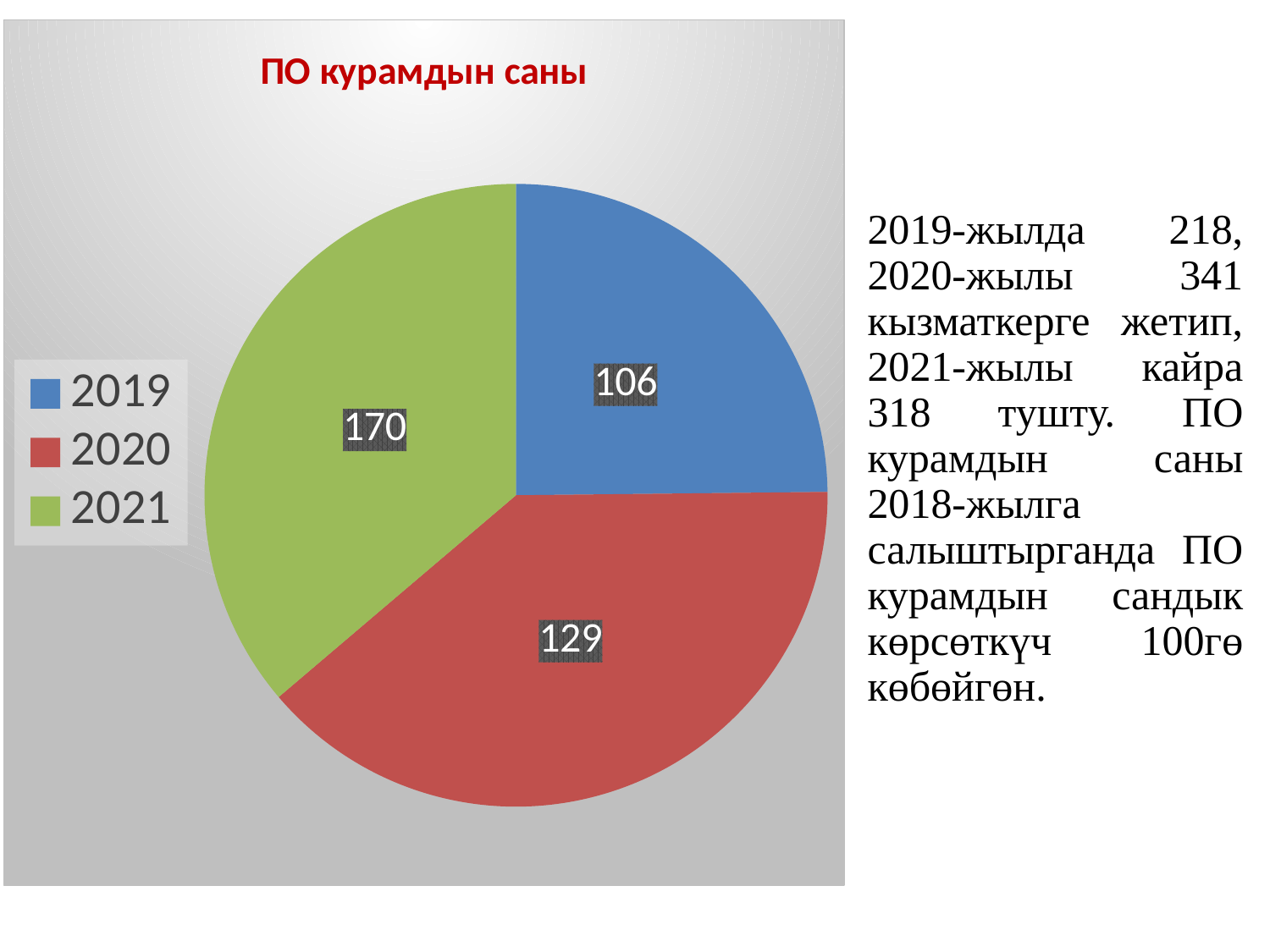
What is the value of the 2020 slice in the pie chart? 129 What is the difference between the 2021 and 2019 values in the pie chart? 64 Which colour represents 2020 in the pie chart? Red How many slices does the pie chart have? 3 Which year has the smallest slice in the pie chart? 2019 What is the title of the chart? ПО курамдын саны What is the value of the 2021 slice in the pie chart? 170 What is the value of the 2019 slice in the pie chart? 106 Which year has the largest slice in the pie chart? 2020 What is the difference between the 2020 and 2019 values in the pie chart? 23 What type of chart is shown on the slide? Pie chart